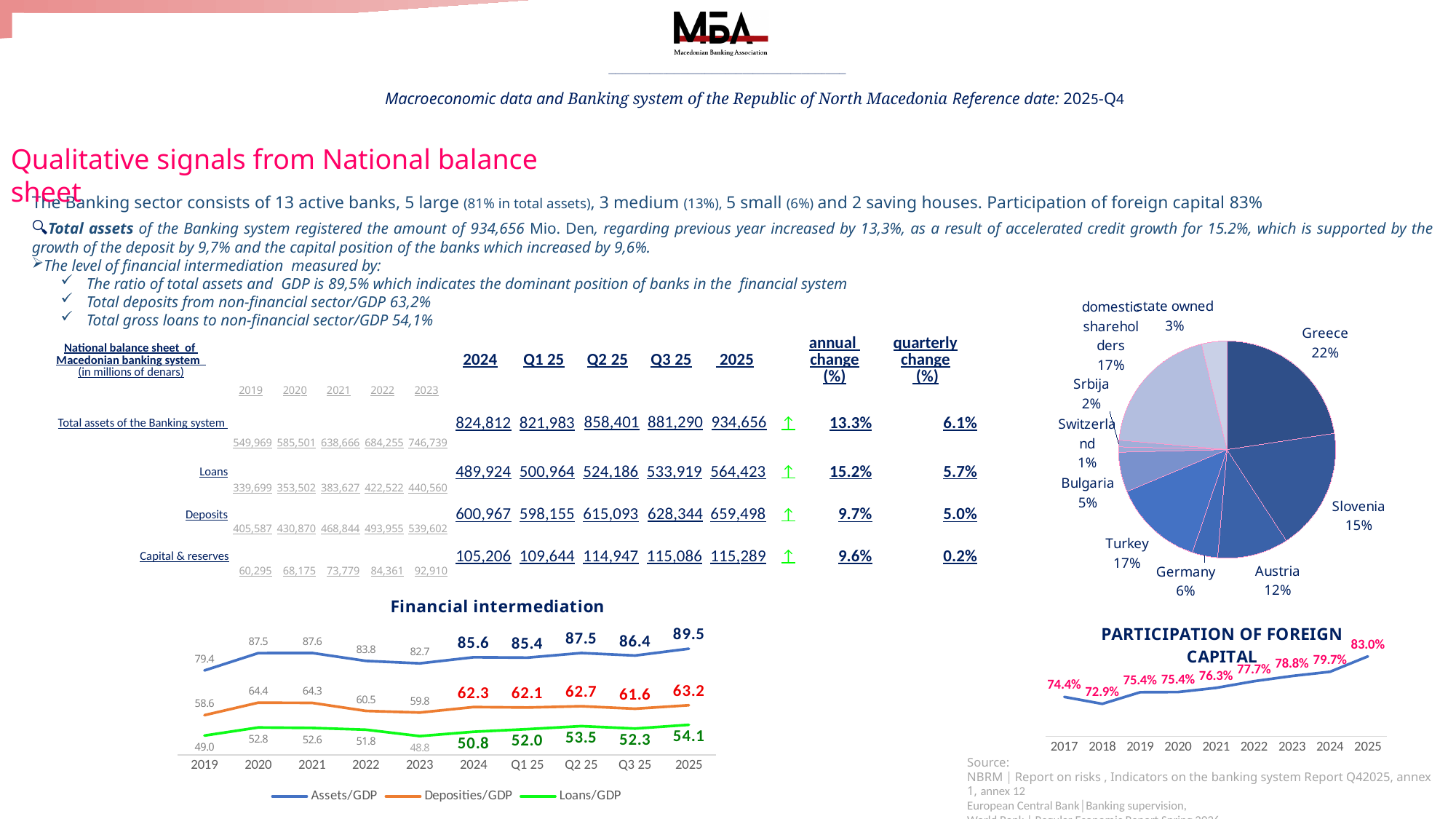
In the pie chart on the right, what share does Greece hold? 22% In the pie chart on the right, which country has the smallest share? Switzerland In the PARTICIPATION OF FOREIGN CAPITAL chart, what is the value for 2018? 72.9% In the Financial intermediation chart, which year has the lowest Assets/GDP value? 2019 In the Financial intermediation chart, what is the Loans/GDP value for 2023? 48.8 In the PARTICIPATION OF FOREIGN CAPITAL chart, how many years are plotted on the x axis? 9 In the pie chart on the right, which is larger, the share of Slovenia or the share of Austria? Slovenia In the Financial intermediation chart, how many series does the legend list? 3 What type of chart is the Financial intermediation chart? Line chart In the Financial intermediation chart, what is the Assets/GDP value for 2025? 89.5 In the Financial intermediation chart, what is the difference between Assets/GDP and Deposities/GDP in 2025? 26.3 In the PARTICIPATION OF FOREIGN CAPITAL chart, which year has the highest value? 2025